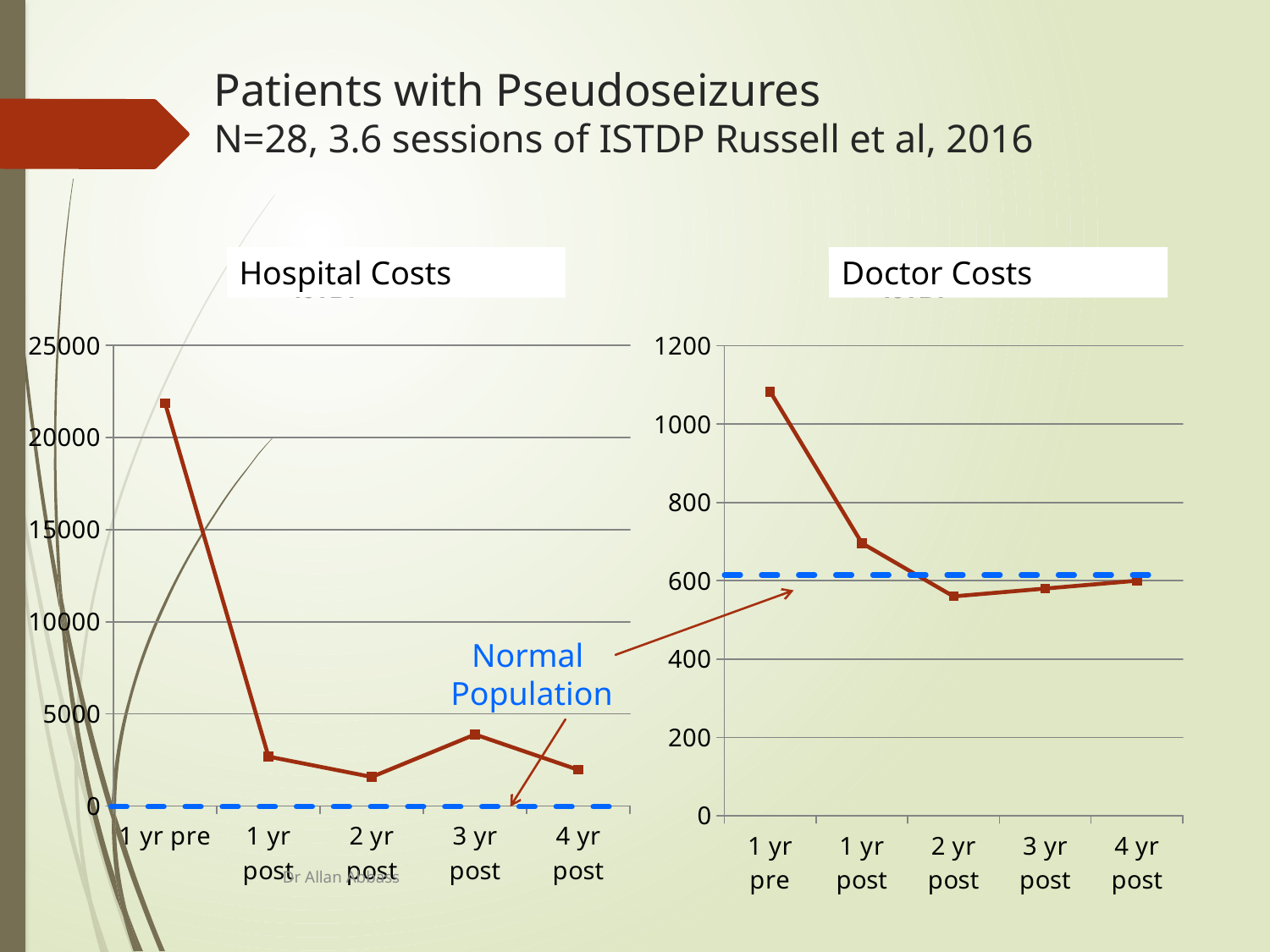
In the Hospital Costs chart, is the value for 1 yr pre greater or less than 20000? greater In the Hospital Costs chart, which time point has the lowest hospital cost? 2 yr post In the Doctor Costs chart, is the value for 2 yr post greater or less than 600? less In the Doctor Costs chart, which time point has the highest doctor cost? 1 yr pre In the Doctor Costs chart, do the values rise or fall from 1 yr pre to 1 yr post? fall In the Hospital Costs chart, is the value for 1 yr post greater or less than 5000? less In the Hospital Costs chart, which time point has the highest hospital cost? 1 yr pre In the Doctor Costs chart, which is larger, the value for 1 yr pre or the value for 1 yr post? 1 yr pre What does the dashed blue line on the charts represent? Normal Population How many time points are plotted on the x axis of the Doctor Costs chart? 5 What kind of chart is the Hospital Costs chart? line chart